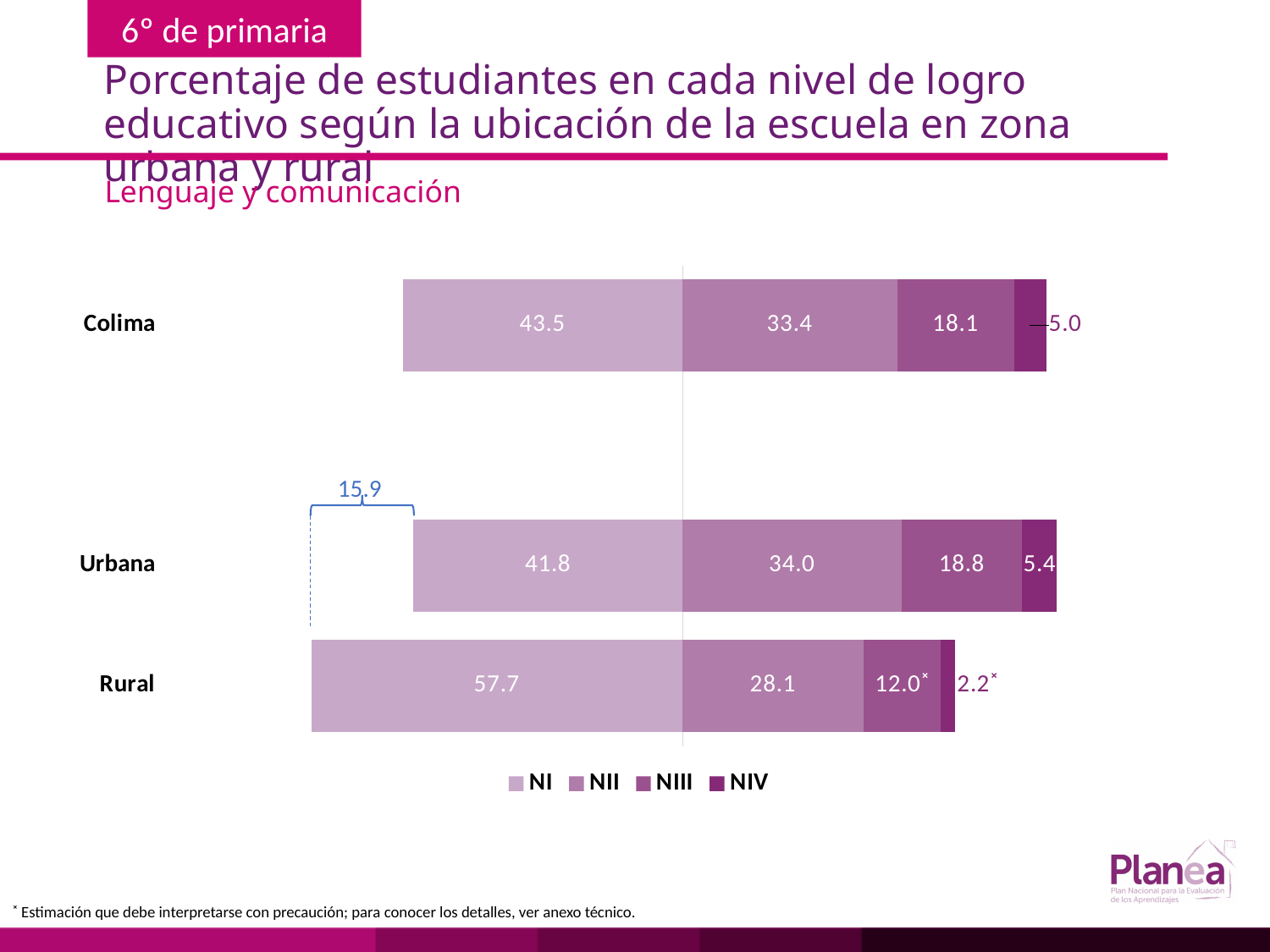
Which is larger, the NIII value for Urbana or the NIII value for Colima? Urbana What is the difference between the NI values for Rural and Urbana? 15.9 What is the NIII value for Rural? 12.0 What is the NII value for Urbana? 34.0 How many categories (bars) are shown in the chart? 3 Which category has the highest NI value? Rural What is the NI value for Rural? 57.7 How many series does the legend list? 4 What is the NIV value for Colima? 5.0 Which category has the lowest NIV value? Rural What kind of chart is shown on the slide? Stacked bar chart What is the total of the stacked bar for Colima? 100.0